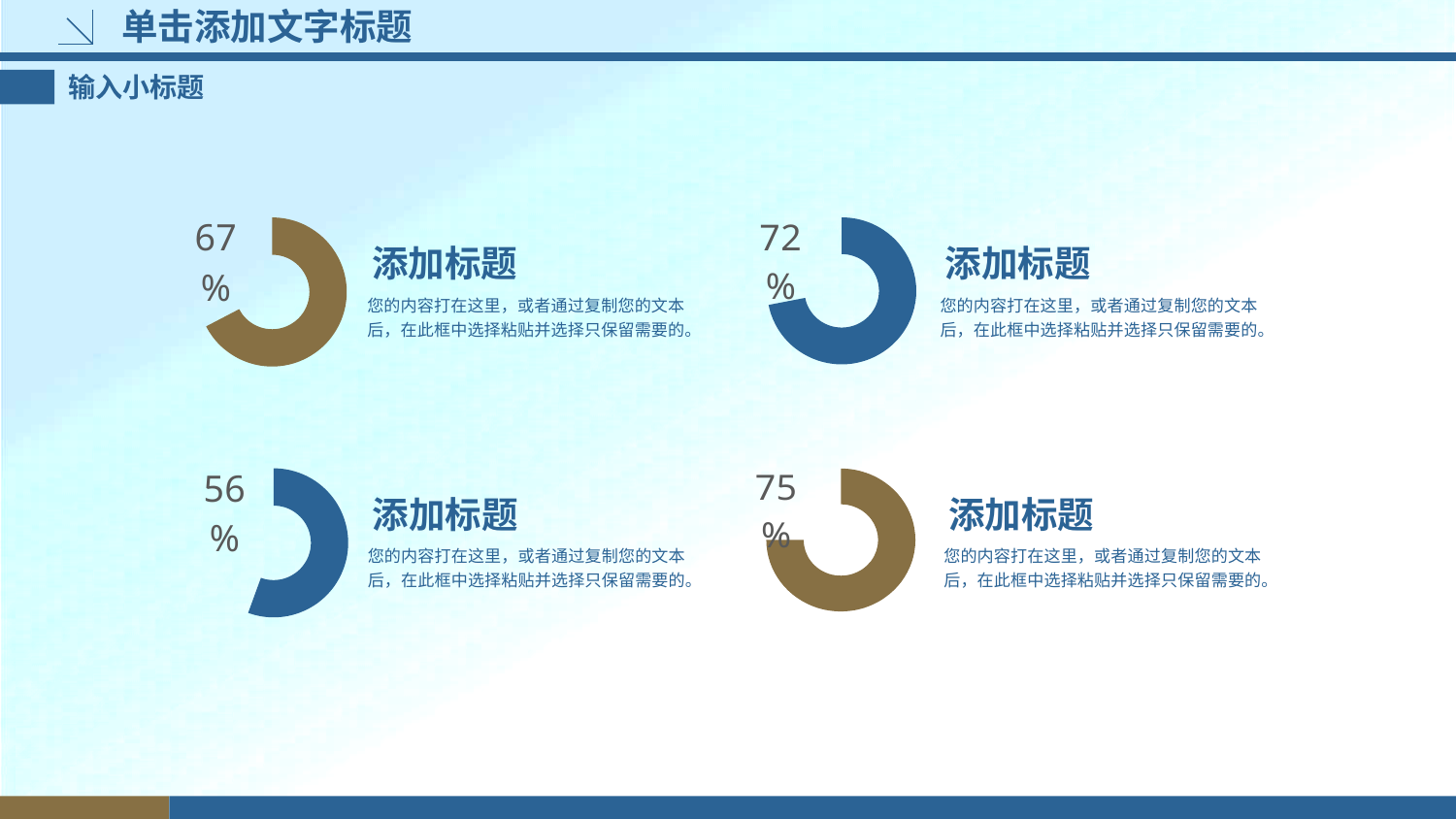
What is the difference between the percentage in the top-right donut chart and the percentage in the top-left donut chart? 5% What kind of chart is used for each of the four figures on the slide? donut chart Which of the four donut charts on the slide shows the highest percentage? bottom-right (75%) What colour is the filled ring of the top-right donut chart? blue What percentage is shown by the top-right donut chart? 72% What percentage is shown by the top-left donut chart? 67% Which of the four donut charts on the slide shows the lowest percentage? bottom-left (56%) What percentage is shown by the bottom-right donut chart? 75% Which shows a larger percentage, the top-left donut chart or the top-right donut chart? top-right How many donut charts are on the slide? 4 What percentage is shown by the bottom-left donut chart? 56% What is the difference between the percentage in the bottom-right donut chart and the percentage in the bottom-left donut chart? 19%